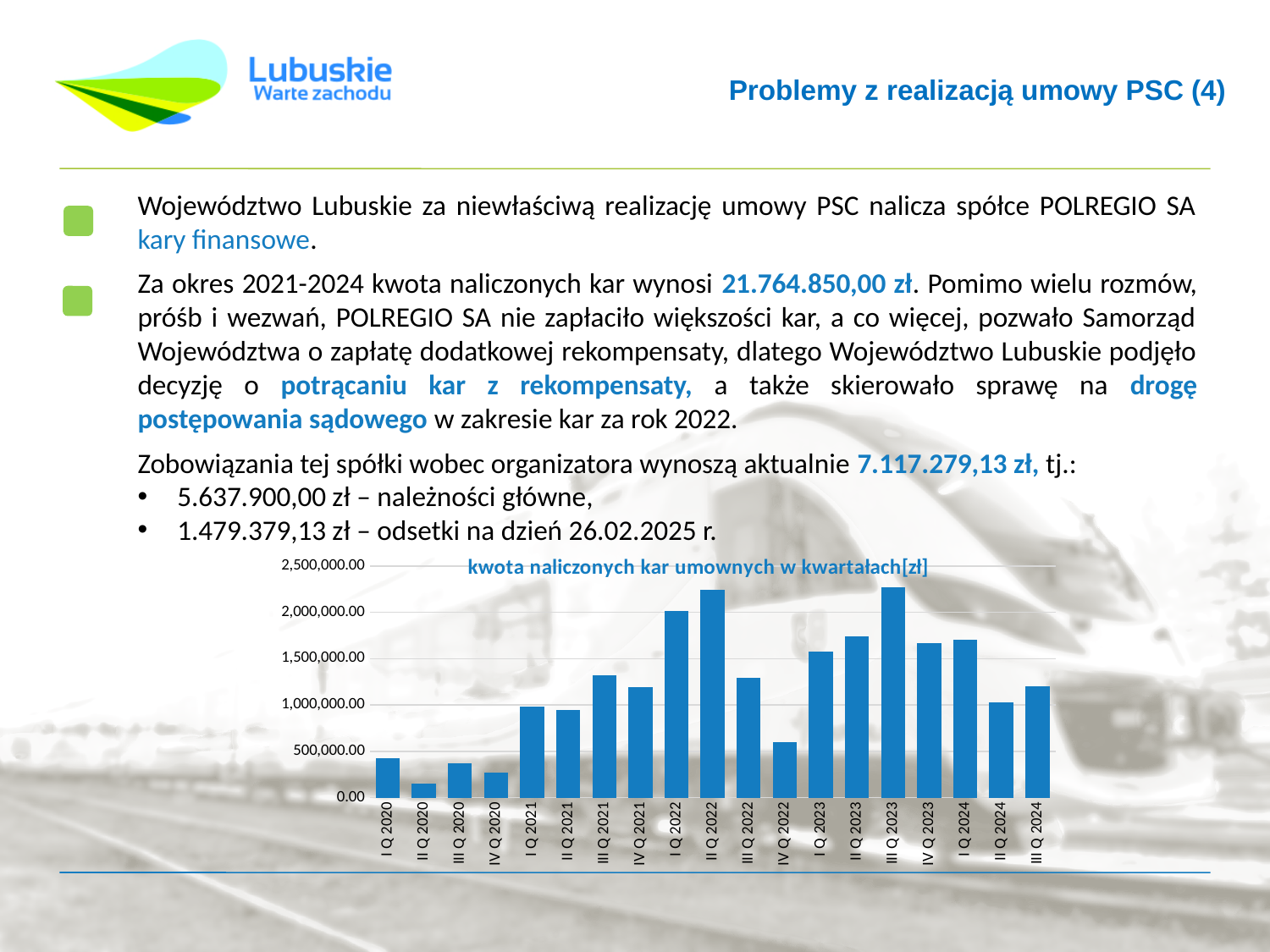
Is the value for IV Q 2022 greater or less than 1,000,000.00? less Is the value for III Q 2021 greater or less than 1,000,000.00? greater Which quarter has the lowest value in the chart? II Q 2020 Do the values generally rise or fall from I Q 2020 to I Q 2022? rise What kind of chart is shown on the slide? bar chart How many quarters (bars) are shown in the chart? 19 What is the title of the chart? kwota naliczonych kar umownych w kwartałach[zł] Which is larger, the value for I Q 2022 or the value for IV Q 2022? I Q 2022 Is the value for III Q 2023 greater or less than 2,000,000.00? greater Which is larger, the value for I Q 2020 or the value for II Q 2020? I Q 2020